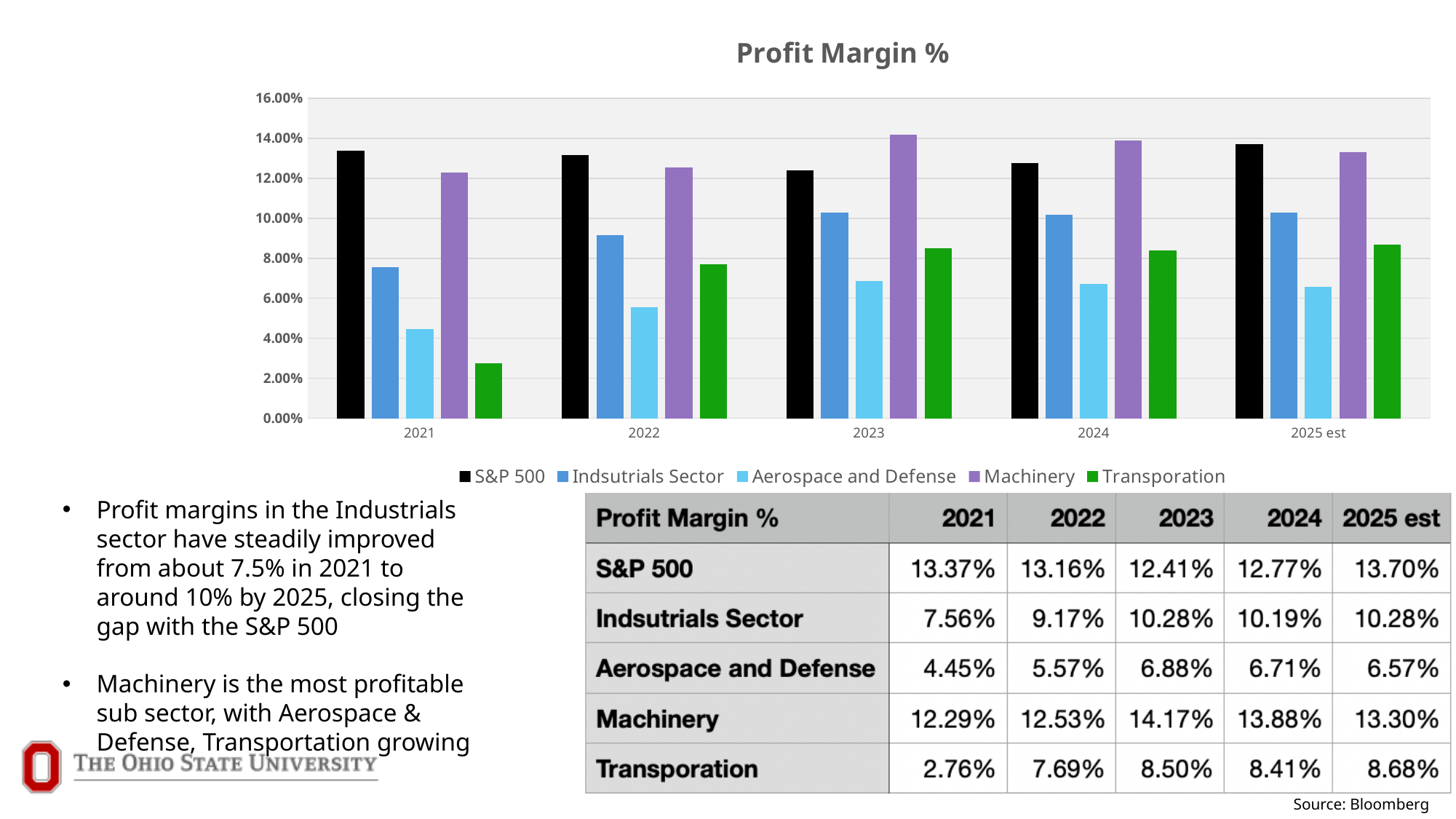
Which series has the lowest profit margin in 2021? Transporation Does the Transporation profit margin rise or fall from 2021 to 2022? rise What is the profit margin for Machinery in 2023? 14.17% What type of chart is shown on the slide? bar chart Which series has the highest profit margin in 2023? Machinery What is the title of the chart? Profit Margin % What is the profit margin for Transporation in 2021? 2.76% How many year categories are shown on the x axis of the chart? 5 What is the difference between the S&P 500 and Indsutrials Sector profit margins in 2021? 5.81% Which is larger in 2024, the S&P 500 profit margin or the Machinery profit margin? Machinery How many series does the chart legend list? 5 Is the Aerospace and Defense profit margin in 2022 greater or less than 6.00%? less